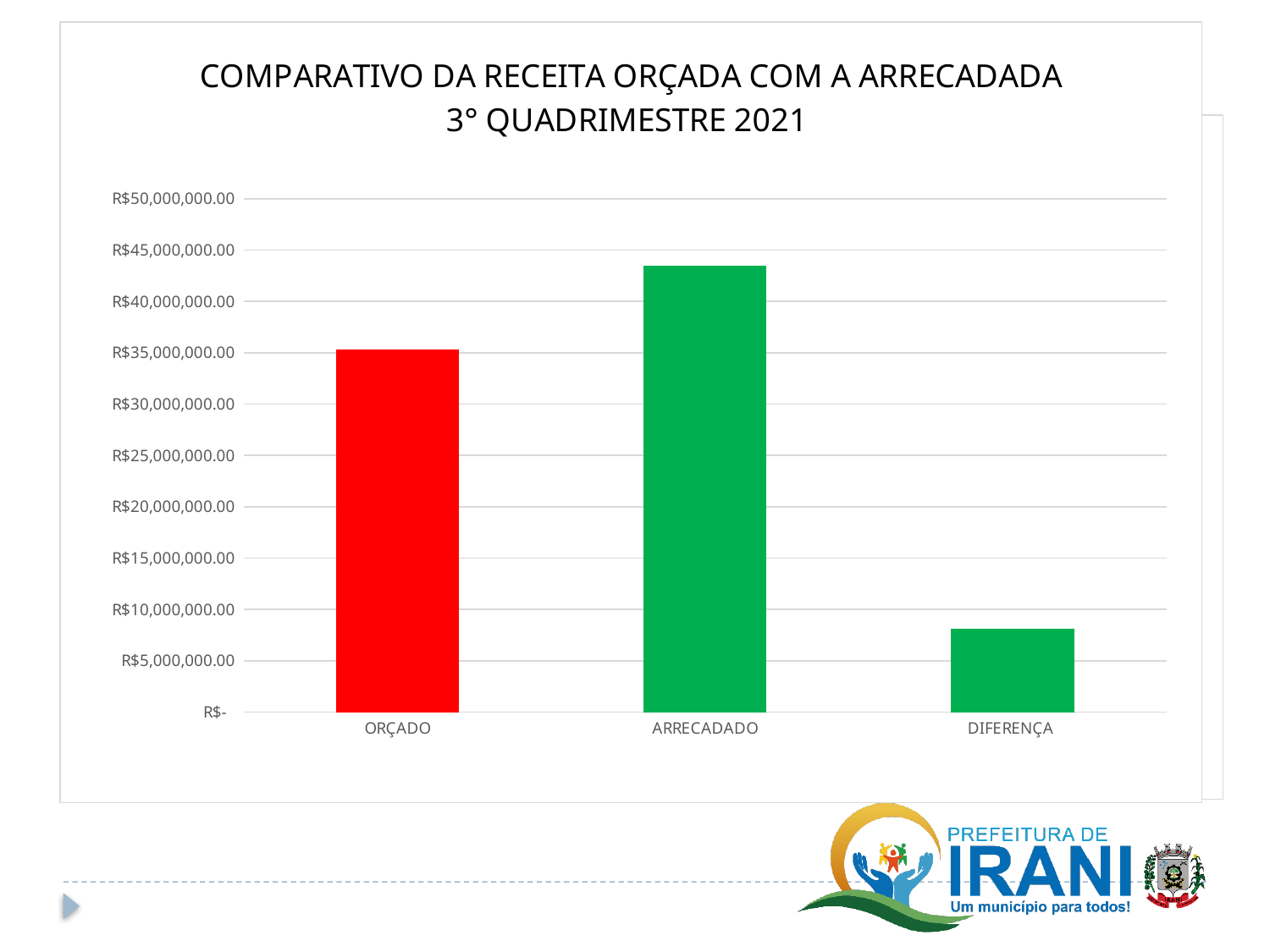
Which is larger, the value for ORÇADO or the value for DIFERENÇA? ORÇADO Which is larger, the value for ORÇADO or the value for ARRECADADO? ARRECADADO What kind of chart is shown on the slide? Bar chart Is the value for ARRECADADO greater or less than R$40,000,000.00? greater Which category has the lowest value in the chart? DIFERENÇA Is the value for DIFERENÇA greater or less than R$10,000,000.00? less Is the value for ORÇADO greater or less than R$30,000,000.00? greater How many categories are shown on the x axis of the chart? 3 What is the title of the chart? COMPARATIVO DA RECEITA ORÇADA COM A ARRECADADA 3° QUADRIMESTRE 2021 What colour is the bar for ORÇADO? Red Which category has the highest value in the chart? ARRECADADO